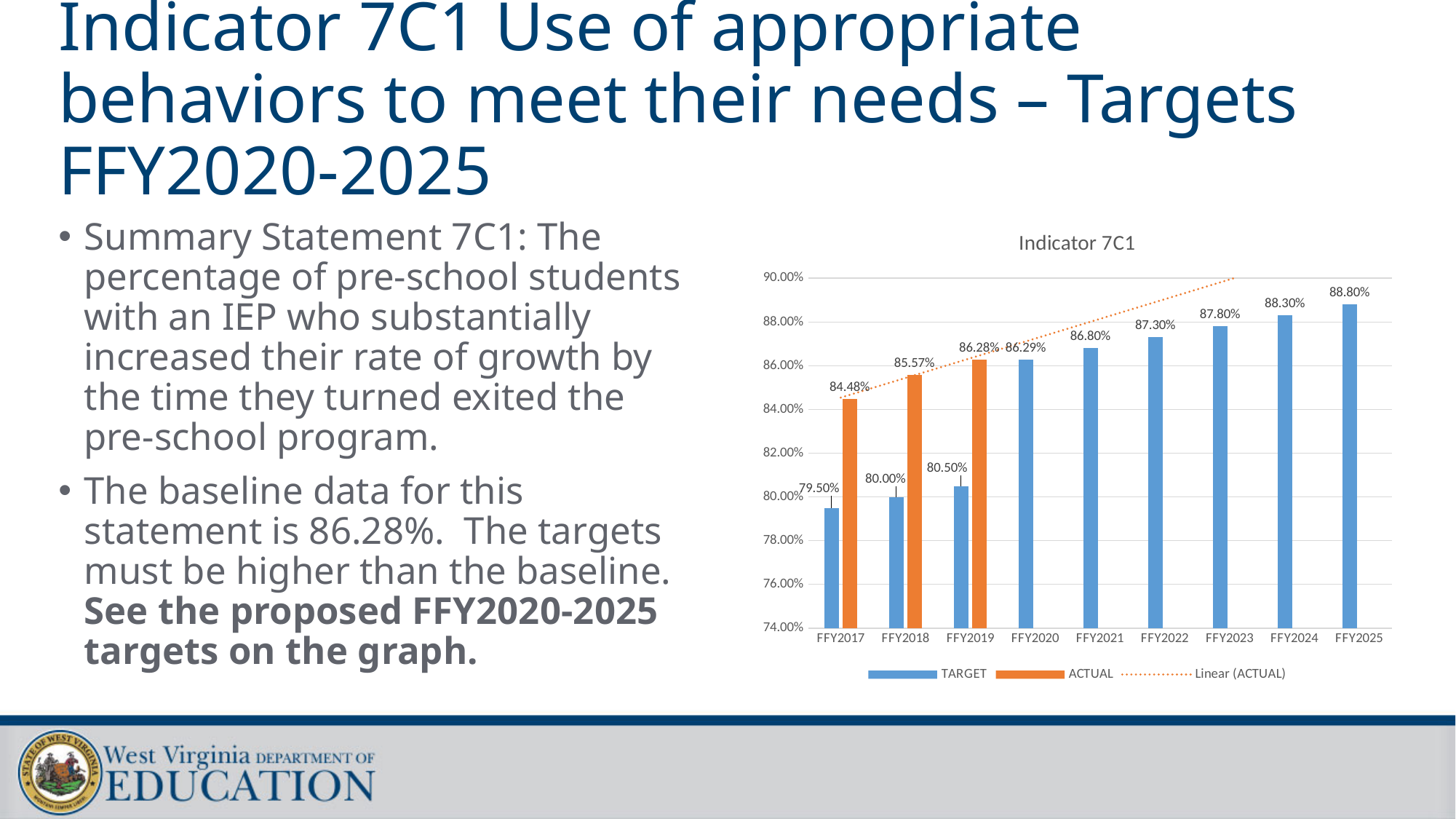
Which is larger for FFY2017, the TARGET or the ACTUAL value? ACTUAL How many years are shown on the x axis? 9 Do the TARGET values rise or fall from FFY2017 to FFY2025? Rise Which year has the lowest TARGET value? FFY2017 Which year has the highest TARGET value? FFY2025 What is the ACTUAL value for FFY2019? 86.28% What is the difference between the TARGET values for FFY2025 and FFY2020? 2.51% How many entries does the legend list? 3 What is the TARGET value for FFY2025? 88.80% What is the TARGET value for FFY2017? 79.50% What is the ACTUAL value for FFY2018? 85.57% What kind of chart is shown? Bar chart